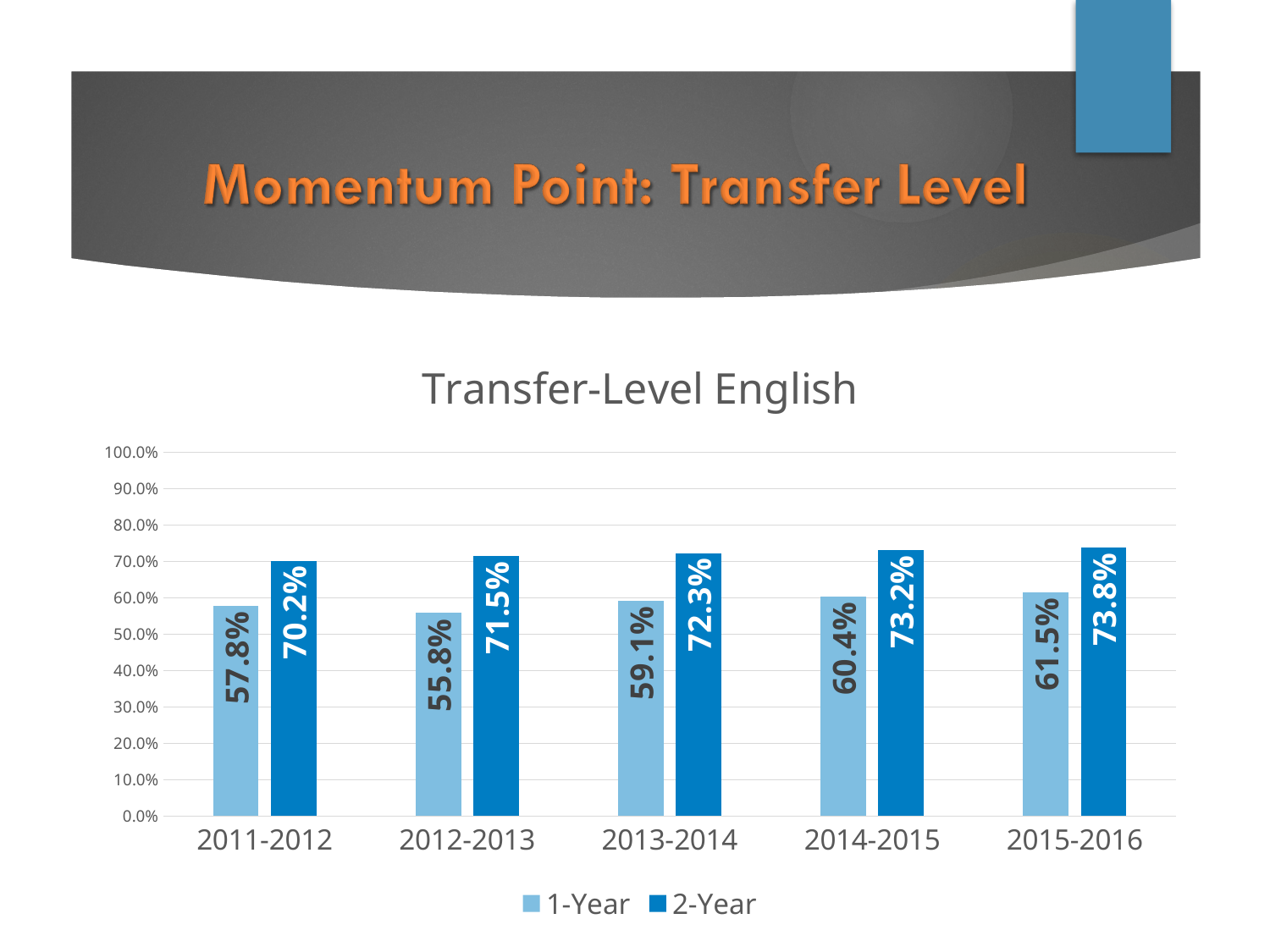
Do the 2-Year values rise or fall from 2011-2012 to 2015-2016? rise How many series does the legend list? 2 What is the 1-Year value for 2011-2012? 57.8% What is the 2-Year value for 2015-2016? 73.8% What kind of chart is shown? bar chart What is the difference between the 2-Year and 1-Year values for 2014-2015? 12.8% How many year categories are shown on the x axis? 5 Is the 2-Year value for 2011-2012 greater or less than 80.0%? less Which is larger, the 1-Year value for 2015-2016 or the 1-Year value for 2013-2014? 2015-2016 What is the 2-Year value for 2013-2014? 72.3% Which year has the lowest 1-Year value? 2012-2013 Which year has the highest 2-Year value? 2015-2016